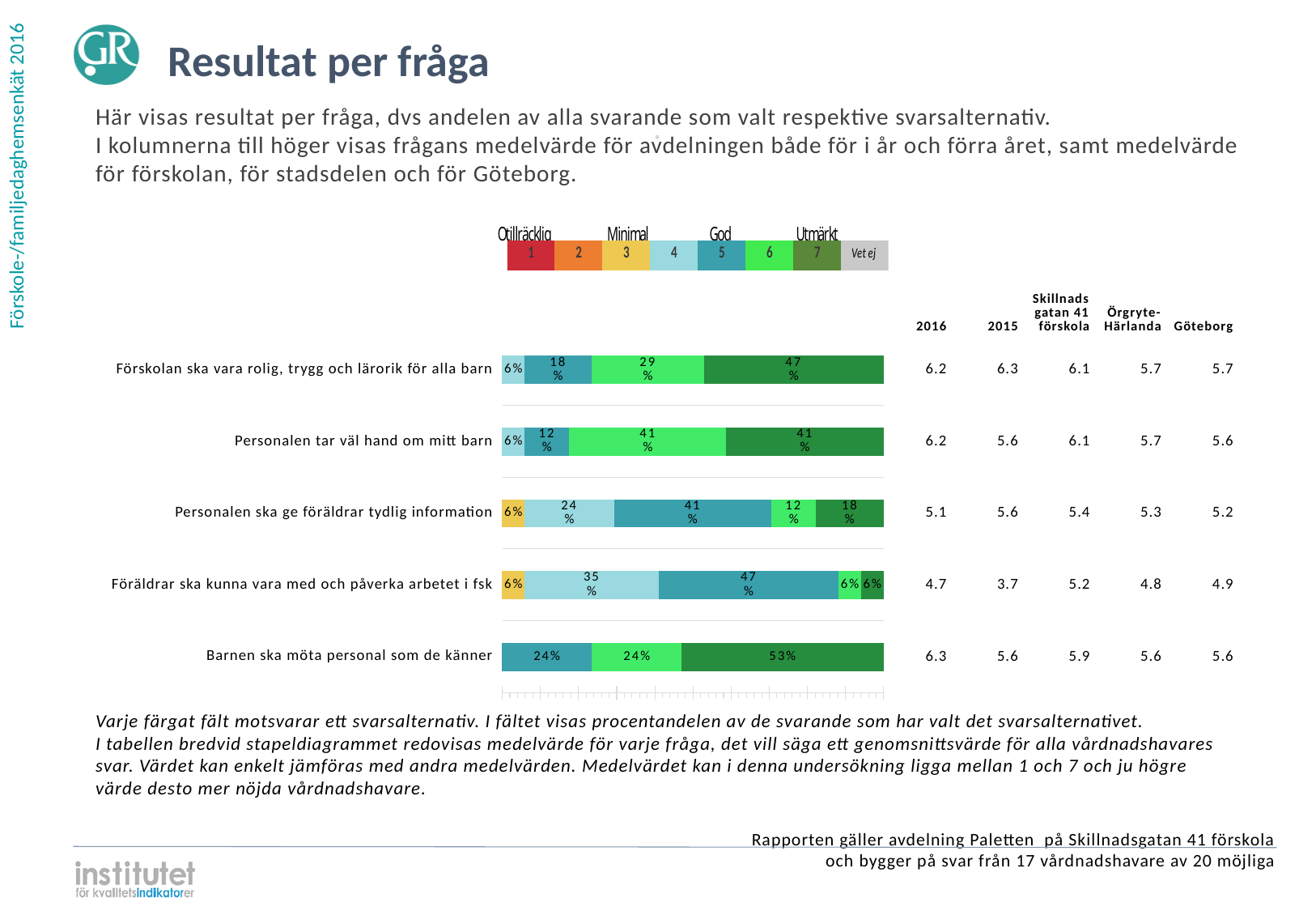
What percentage chose the light blue alternative (4) for 'Personalen ska ge föräldrar tydlig information'? 24% What percentage chose the bright green alternative (6) for 'Personalen tar väl hand om mitt barn'? 41% Which question has the smallest share of respondents choosing the dark green alternative (7)? Föräldrar ska kunna vara med och påverka arbetet i fsk Which question has the largest share of respondents choosing the dark green alternative (7)? Barnen ska möta personal som de känner What percentage of respondents chose the dark green alternative (7) for 'Förskolan ska vara rolig, trygg och lärorik för alla barn'? 47% What percentage chose the teal alternative (5) for 'Föräldrar ska kunna vara med och påverka arbetet i fsk'? 47% What kind of chart is shown on the slide? Stacked bar chart Which is larger: the share choosing 7 for 'Förskolan ska vara rolig, trygg och lärorik för alla barn' or for 'Personalen tar väl hand om mitt barn'? Förskolan ska vara rolig, trygg och lärorik för alla barn In the table next to the chart, what is the 2016 mean value for 'Barnen ska möta personal som de känner'? 6.3 For 'Förskolan ska vara rolig, trygg och lärorik för alla barn', what is the difference between the share choosing 7 (47%) and the share choosing 6 (29%)? 18 percentage points How many questions (categories) are plotted in the bar chart? 5 How many answer alternatives does the legend above the chart list? 8